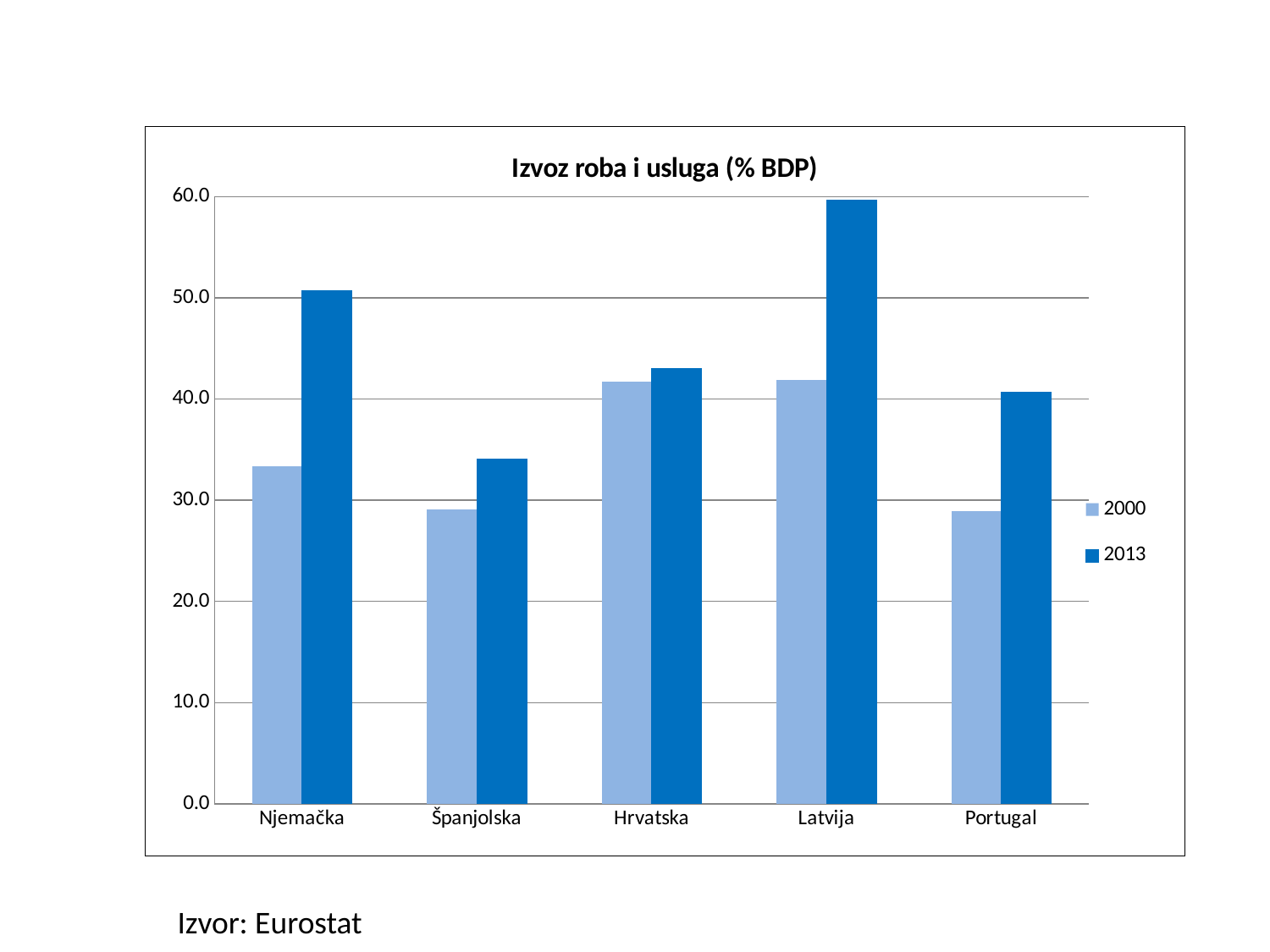
Is the 2000 value for Hrvatska greater or less than 40? greater Which country has the highest value for 2013? Latvija Is the 2013 value for Španjolska greater or less than 40? less How many series does the legend list? 2 Is the 2013 value for Latvija greater or less than 50? greater Which country has the lowest value for 2013? Španjolska What is the title of the chart? Izvoz roba i usluga (% BDP) What type of chart is shown on the slide? bar chart Which is larger for 2013: Njemačka or Hrvatska? Njemačka How many countries are shown on the x axis? 5 Which is larger for Portugal: the 2000 value or the 2013 value? 2013